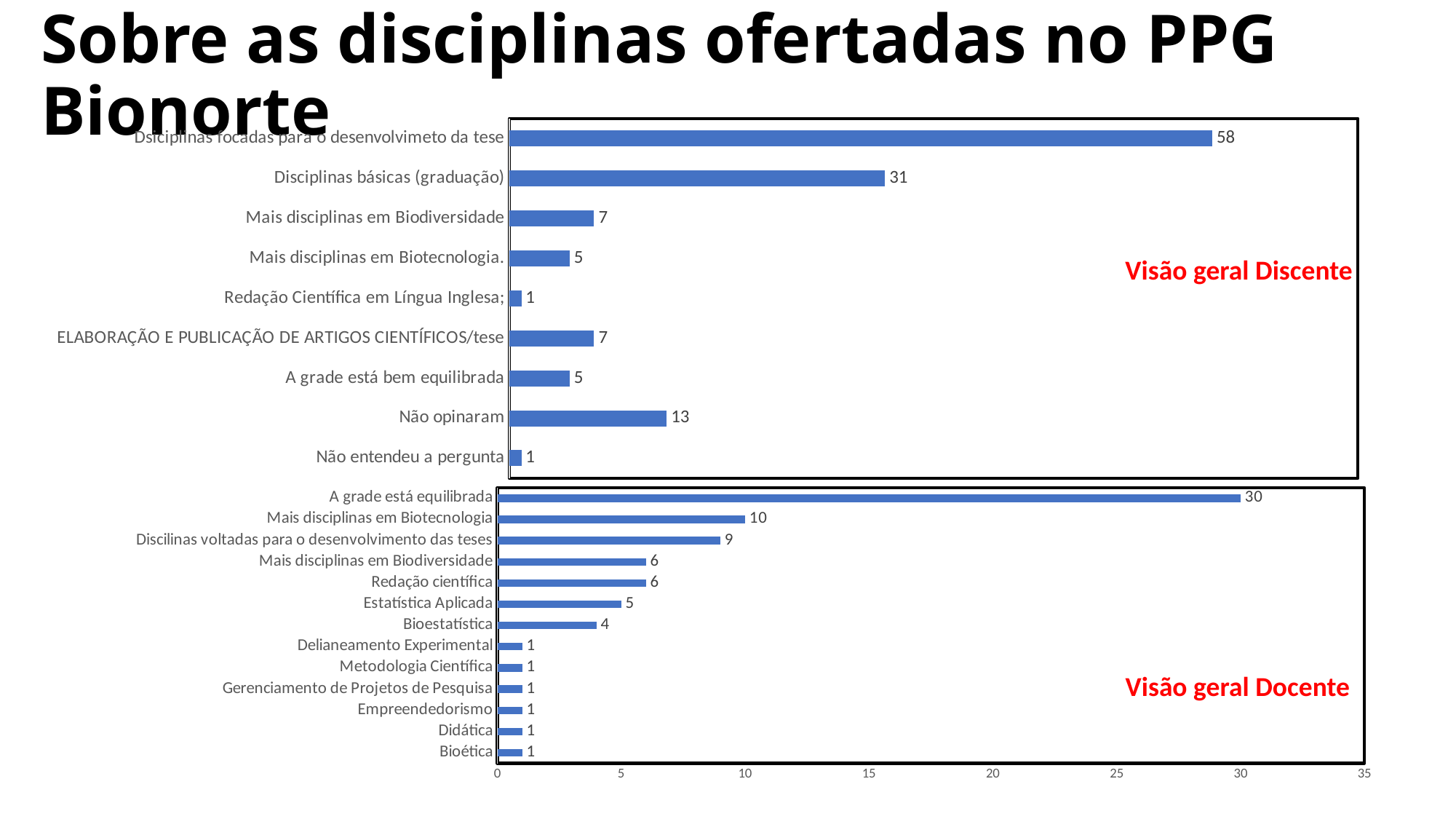
In the 'Visão geral Discente' chart, what is the value for 'Disciplinas básicas (graduação)'? 31 In the 'Visão geral Discente' chart, what is the value for 'Não opinaram'? 13 In the 'Visão geral Discente' chart, what is the difference between 'Dsiciplinas focadas para o desenvolvimeto da tese' and 'Disciplinas básicas (graduação)'? 27 In the 'Visão geral Docente' chart, what is the value for 'Bioestatística'? 4 In the 'Visão geral Docente' chart, how many categories are shown? 13 What type of chart is the 'Visão geral Docente' chart? Bar chart In the 'Visão geral Docente' chart, what is the value for 'Mais disciplinas em Biotecnologia'? 10 In the 'Visão geral Discente' chart, which category has the highest value? Dsiciplinas focadas para o desenvolvimeto da tese In the 'Visão geral Discente' chart, how many categories are shown? 9 In the 'Visão geral Docente' chart, which category has the highest value? A grade está equilibrada In the 'Visão geral Docente' chart, which is larger: 'Estatística Aplicada' or 'Redação científica'? Redação científica In the 'Visão geral Docente' chart, what is the difference between 'A grade está equilibrada' and 'Disciplinas voltadas para o desenvolvimento das teses'? 21